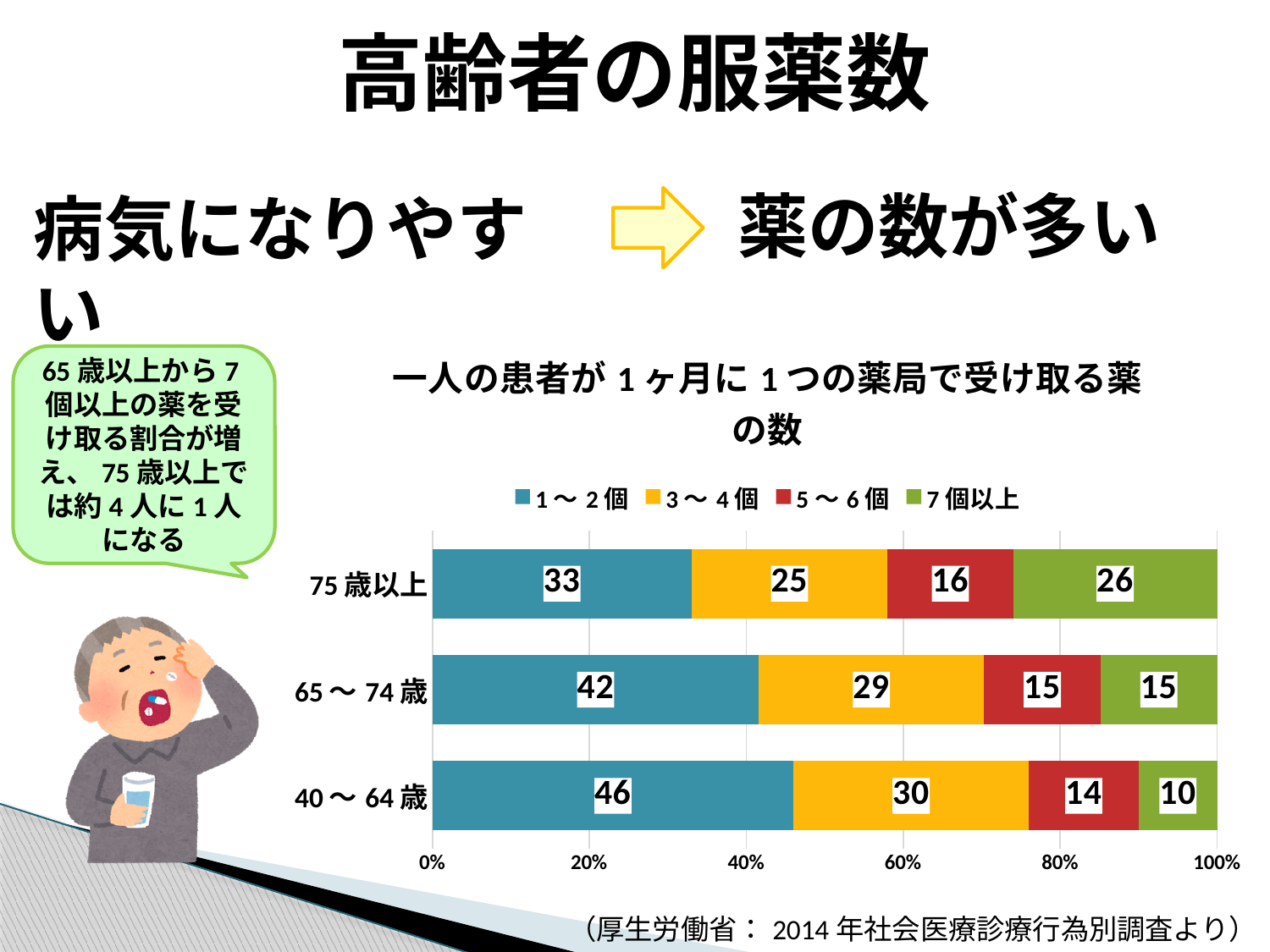
Which age category has the highest value for the 7個以上 series? 75歳以上 What is the value of the 1～2個 series for 75歳以上? 33 Which age category has the lowest value for the 1～2個 series? 75歳以上 What is the value of the 3～4個 series for 65～74歳? 29 What kind of chart is shown on the slide? Stacked bar chart How many series does the chart legend list? 4 Which is larger: the 5～6個 value for 75歳以上 or for 65～74歳? 75歳以上 What is the title of the chart? 一人の患者が1ヶ月に1つの薬局で受け取る薬の数 What is the value of the 7個以上 series for 40～64歳? 10 What is the difference between the 7個以上 values for 75歳以上 and 40～64歳? 16 What is the total of the stacked bar for 65～74歳? 101 How many age categories are plotted in the chart? 3